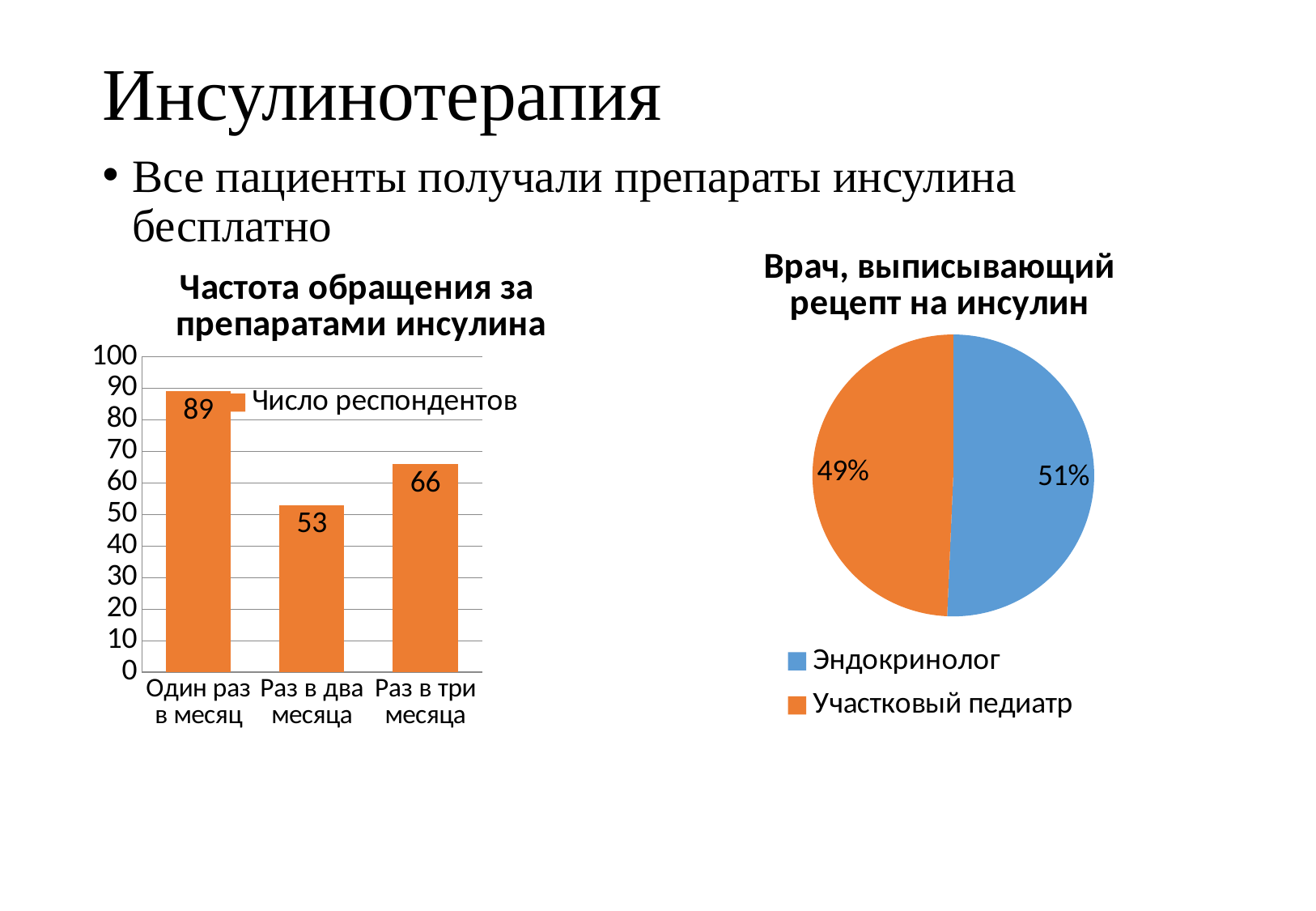
In the chart 'Частота обращения за препаратами инсулина', what is the value for 'Один раз в месяц'? 89 What kind of chart is 'Частота обращения за препаратами инсулина'? Bar chart In the chart 'Частота обращения за препаратами инсулина', which category has the highest value? Один раз в месяц In the chart 'Частота обращения за препаратами инсулина', how many categories are shown? 3 In the chart 'Врач, выписывающий рецепт на инсулин', what share does 'Эндокринолог' have? 51% In the chart 'Частота обращения за препаратами инсулина', what is the difference between the values for 'Один раз в месяц' and 'Раз в два месяца'? 36 In the chart 'Частота обращения за препаратами инсулина', which category has the lowest value? Раз в два месяца In the chart 'Частота обращения за препаратами инсулина', what is the value for 'Раз в три месяца'? 66 In the chart 'Частота обращения за препаратами инсулина', what series name does the legend show? Число респондентов In the chart 'Врач, выписывающий рецепт на инсулин', what share does 'Участковый педиатр' have? 49% What kind of chart is 'Врач, выписывающий рецепт на инсулин'? Pie chart In the chart 'Частота обращения за препаратами инсулина', what is the value for 'Раз в два месяца'? 53